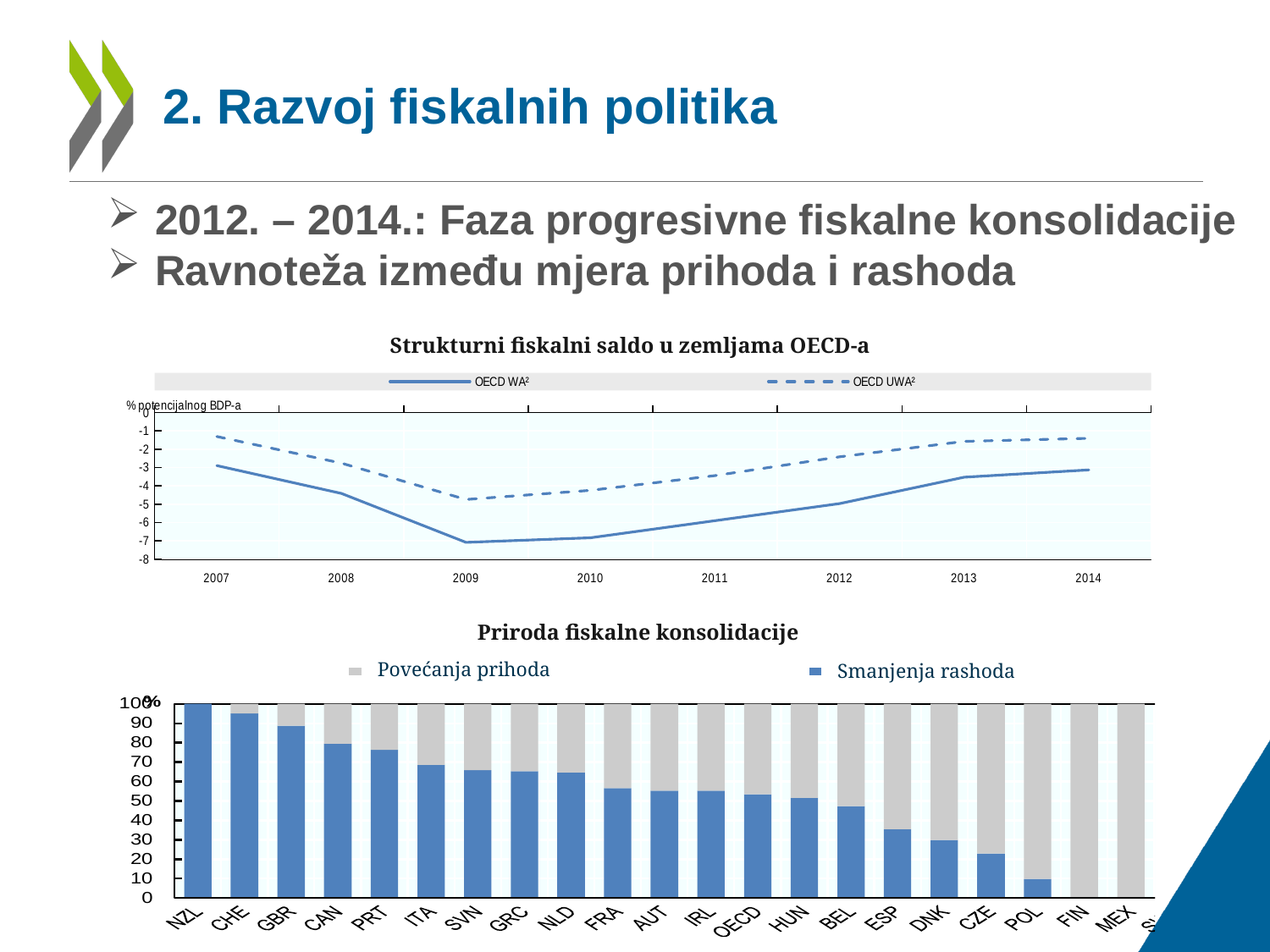
In the top chart 'Strukturni fiskalni saldo u zemljama OECD-a', is the OECD UWA value for 2007 greater or less than -2? greater In the bottom chart 'Priroda fiskalne konsolidacije', which country has the highest share of Smanjenja rashoda? NZL What kind of chart is the bottom chart titled 'Priroda fiskalne konsolidacije'? Bar chart In the top chart 'Strukturni fiskalni saldo u zemljama OECD-a', how many series does the legend list? 2 In the top chart 'Strukturni fiskalni saldo u zemljama OECD-a', is the OECD WA value for 2009 greater or less than -6? less What kind of chart is the top chart titled 'Strukturni fiskalni saldo u zemljama OECD-a'? Line chart In the top chart 'Strukturni fiskalni saldo u zemljama OECD-a', does the OECD WA series rise or fall from 2009 to 2014? Rise In the bottom chart 'Priroda fiskalne konsolidacije', is the Smanjenja rashoda value for CAN greater or less than 70? greater In the top chart 'Strukturni fiskalni saldo u zemljama OECD-a', how many years are shown on the x axis? 8 In the top chart 'Strukturni fiskalni saldo u zemljama OECD-a', which series has the higher value in 2012, OECD WA or OECD UWA? OECD UWA In the top chart 'Strukturni fiskalni saldo u zemljama OECD-a', in which year does the OECD WA series reach its lowest value? 2009 In the bottom chart 'Priroda fiskalne konsolidacije', which has the larger Smanjenja rashoda share, GBR or ESP? GBR